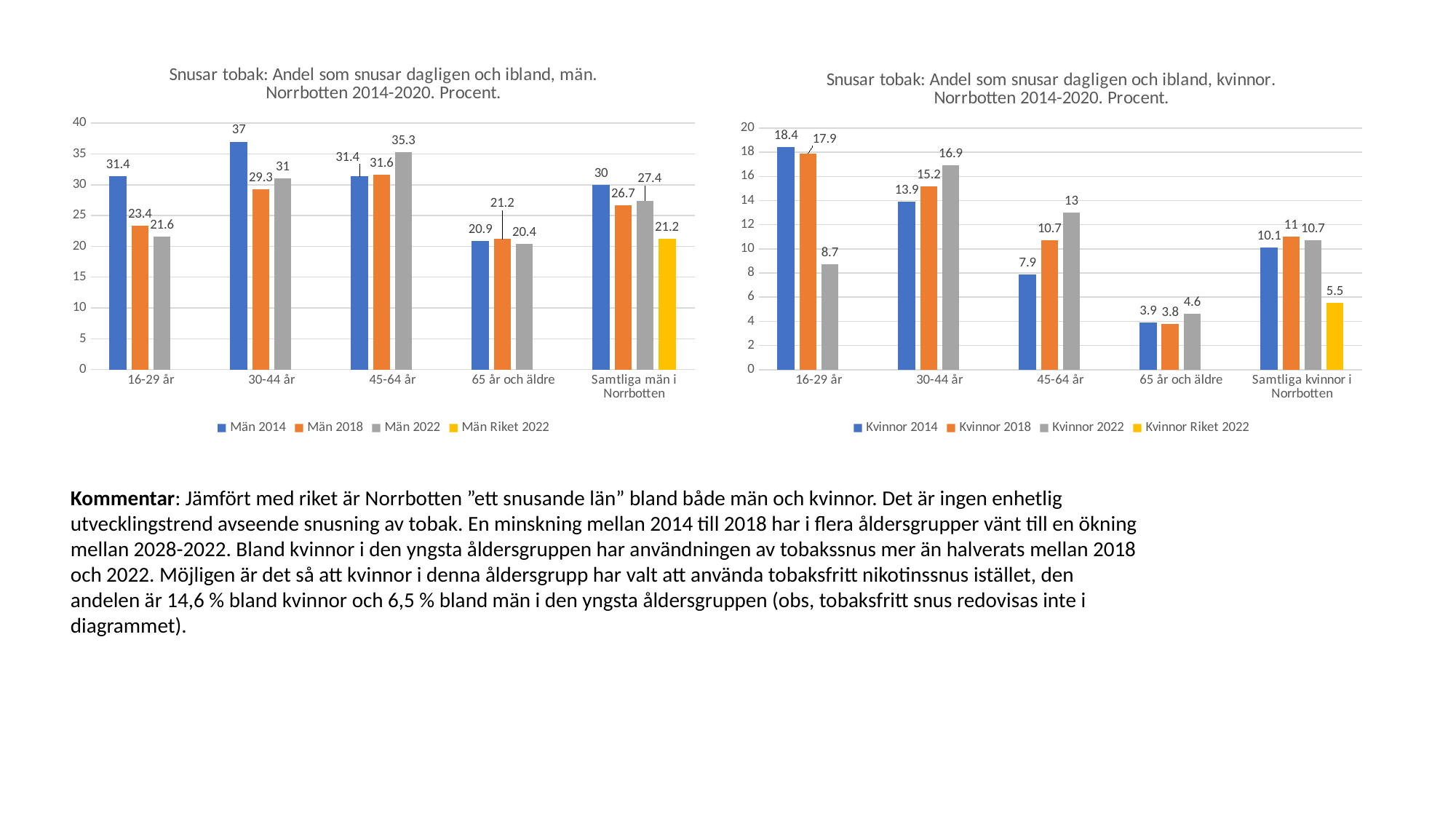
In the right chart (women), what colour are the Kvinnor Riket 2022 bars? Yellow In the right chart (women), what is the difference between Kvinnor 2018 and Kvinnor 2022 in the 16-29 år group? 9.2 In the left chart (men), what is the value for Män Riket 2022 for Samtliga män i Norrbotten? 21.2 In the left chart (men), which is larger for the 16-29 år group: Män 2014 or Män 2018? Män 2014 In the right chart (women), what is the value for Kvinnor 2022 in the 16-29 år group? 8.7 In the left chart (men), which age group has the highest Män 2022 value? 45-64 år In the left chart (men), what is the value for Män 2014 in the 30-44 år group? 37 How many age-group categories are shown on the x axis of the left chart (men)? 5 How many series does the legend of the right chart (women) list? 4 In the right chart (women), which age group has the lowest Kvinnor 2014 value? 65 år och äldre In the right chart (women), what is the value for Kvinnor 2018 for Samtliga kvinnor i Norrbotten? 11 What kind of chart is the left chart (men)? Bar chart